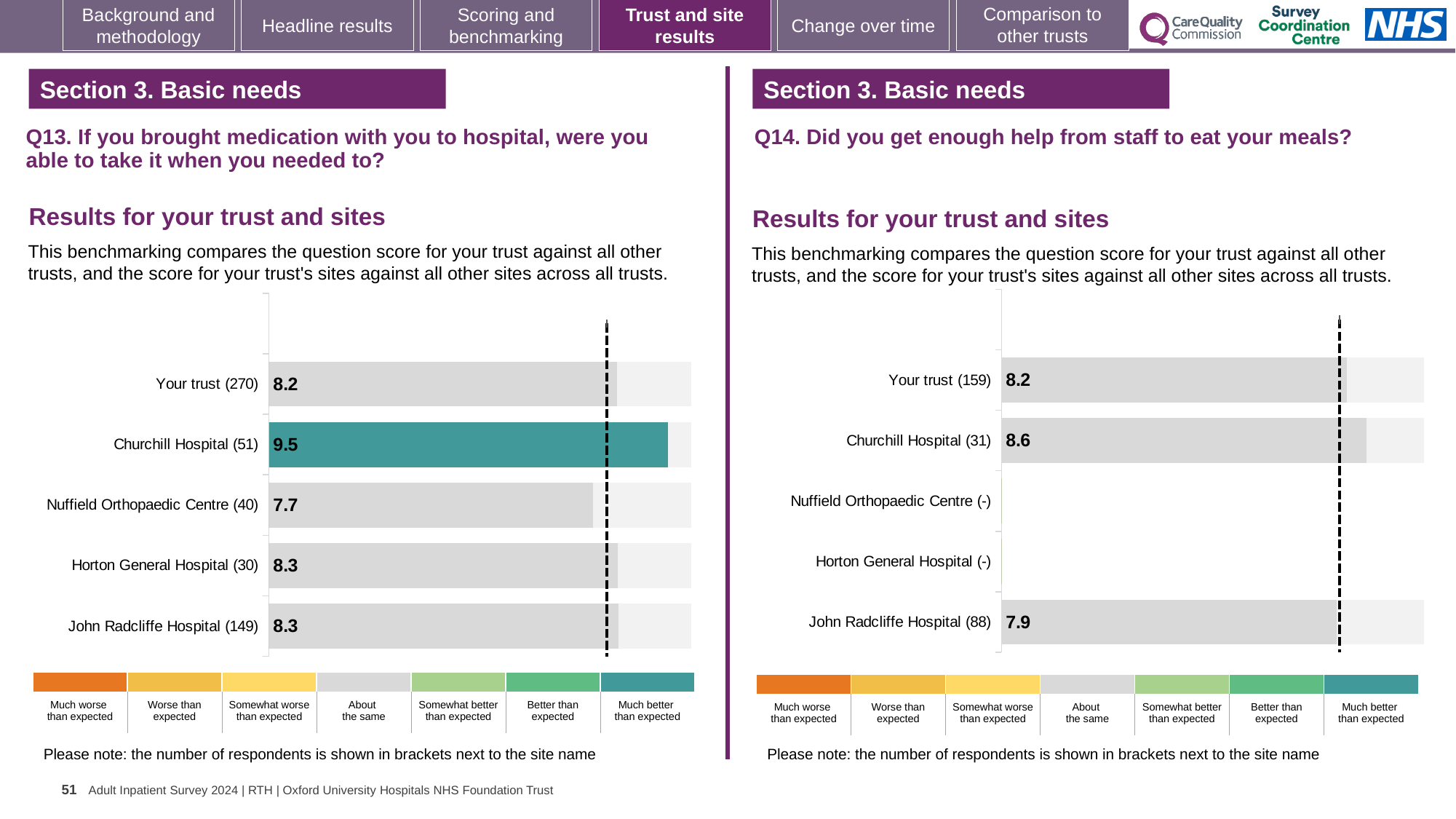
On the Q13 chart (left), which benchmark category does the colour of the Churchill Hospital bar correspond to? Much better than expected On the Q13 chart (left), how many respondents are shown for John Radcliffe Hospital? 149 On the Q13 chart (left), which site has the lowest score? Nuffield Orthopaedic Centre On the Q13 chart (left), which site has the highest score? Churchill Hospital On the Q13 chart (left), what is the score for Churchill Hospital? 9.5 On the Q14 chart (right), what is the score for John Radcliffe Hospital? 7.9 On the Q14 chart (right), how many sites have a score bar plotted? 3 What type of chart is used on the Q13 chart (left)? Bar chart On the Q14 chart (right), which is higher, the score for Your trust or for John Radcliffe Hospital? Your trust On the Q13 chart (left), what is the difference between the Churchill Hospital score and the Your trust score? 1.3 On the Q13 chart (left), what is the score for Nuffield Orthopaedic Centre? 7.7 On the Q14 chart (right), what is the score for Churchill Hospital? 8.6